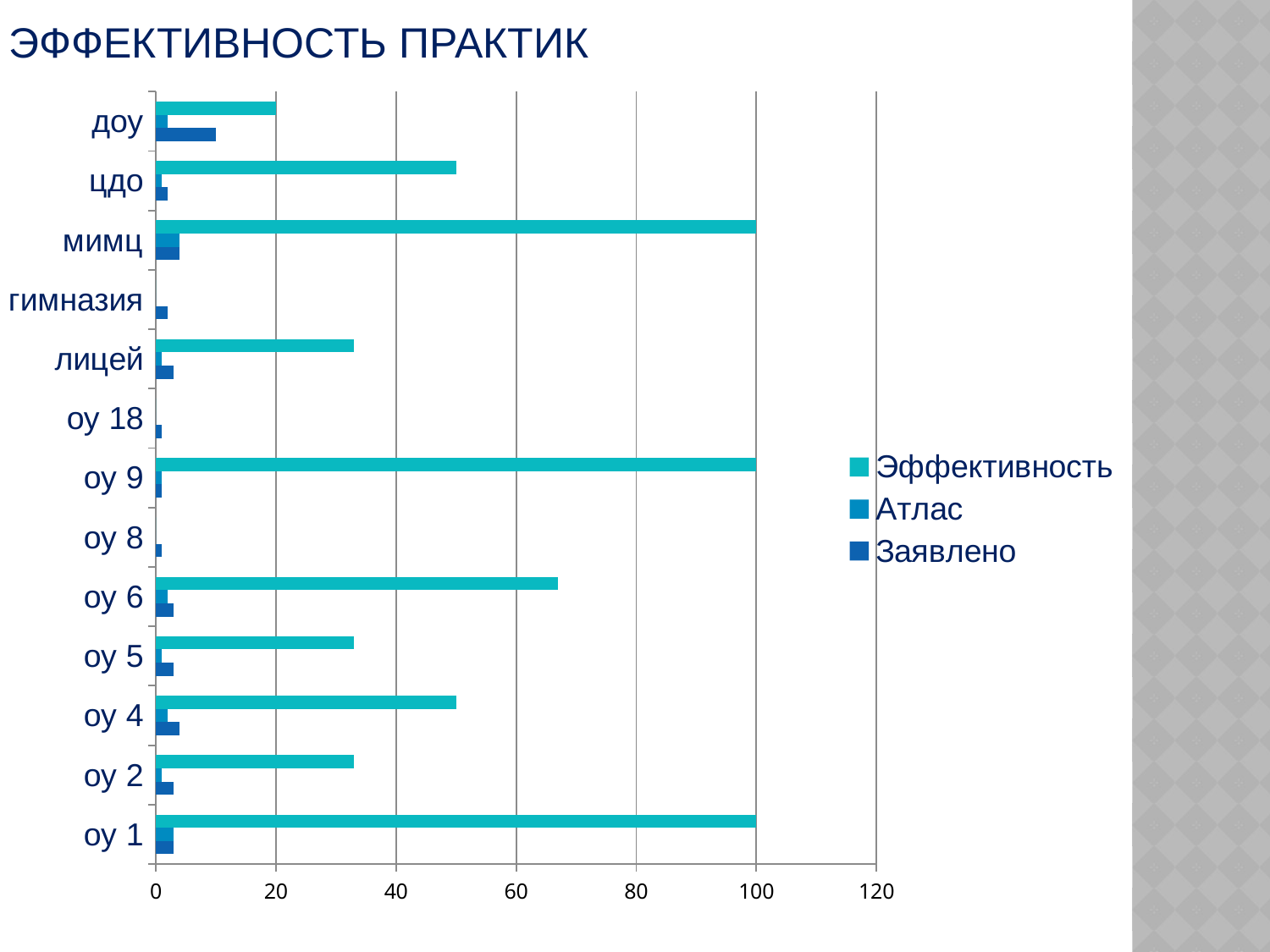
What is the Эффективность value for оу 1? 100 Is the Эффективность value for цдо greater or less than 40? greater What is the Эффективность value for доу? 20 Is the Эффективность value for оу 6 greater or less than 60? greater What kind of chart is shown on the slide? bar chart Is the Эффективность value for лицей greater or less than 40? less What is the Эффективность value for мимц? 100 How many categories are shown on the vertical axis? 13 Which has the larger Эффективность value, оу 6 or оу 5? оу 6 Which has the larger Эффективность value, доу or цдо? цдо What is the title of the chart? ЭФФЕКТИВНОСТЬ ПРАКТИК How many series does the legend list? 3